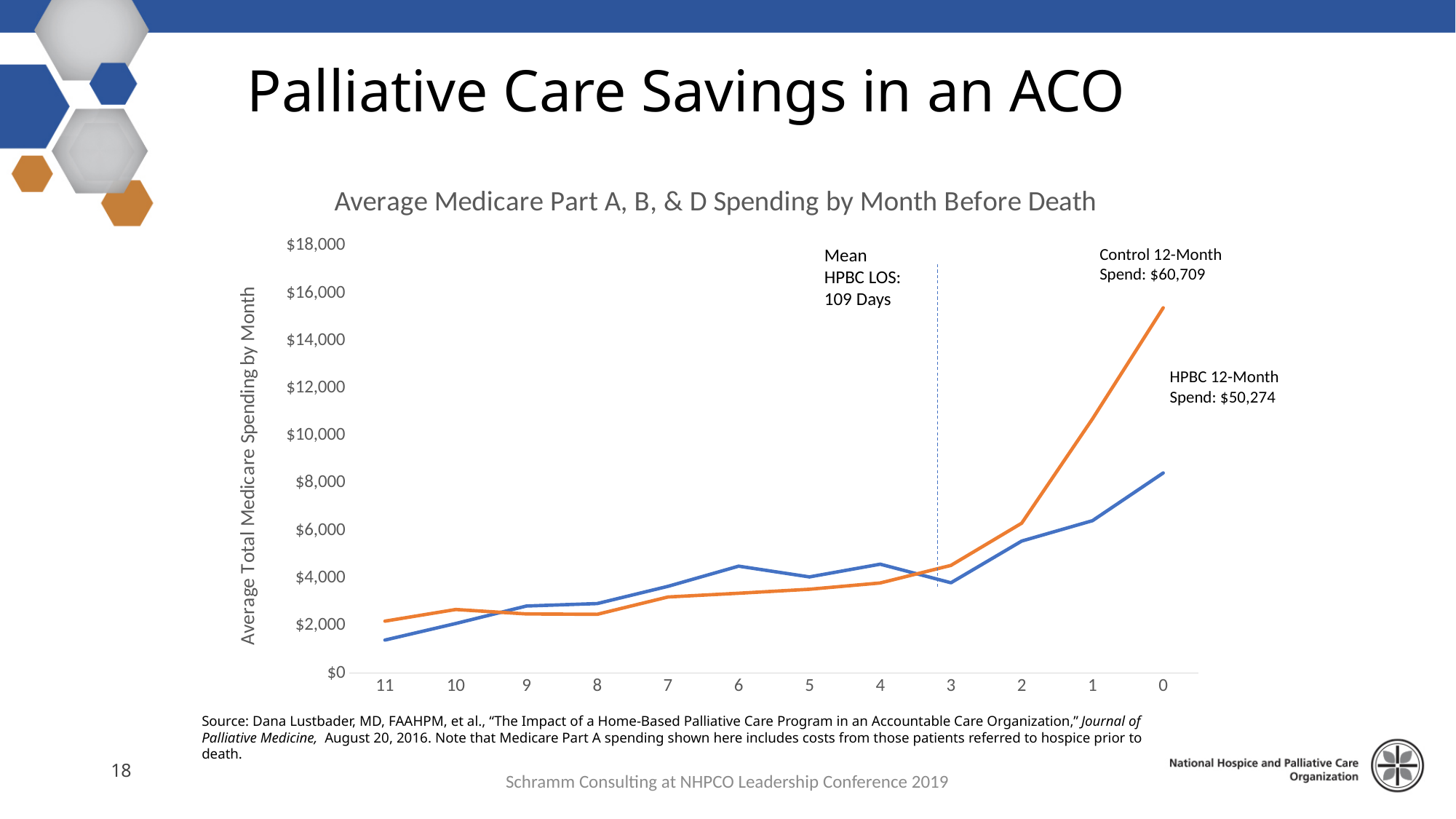
What is the HPBC 12-Month Spend shown on the chart? $50,274 At month 0, which line is higher, Control or HPBC? Control What is the Control 12-Month Spend shown on the chart? $60,709 At which month before death does the Control line reach its highest value? 0 What is the title of the chart? Average Medicare Part A, B, & D Spending by Month Before Death How many months are plotted along the x axis of the chart? 12 What kind of chart is shown on the slide? line chart What is the difference between the Control 12-Month Spend and the HPBC 12-Month Spend? $10,435 What is the label on the vertical axis of the chart? Average Total Medicare Spending by Month How many lines are plotted on the chart? 2 Is the HPBC spending at month 11 greater or less than $2,000? less Is the Control spending at month 0 greater or less than $14,000? greater